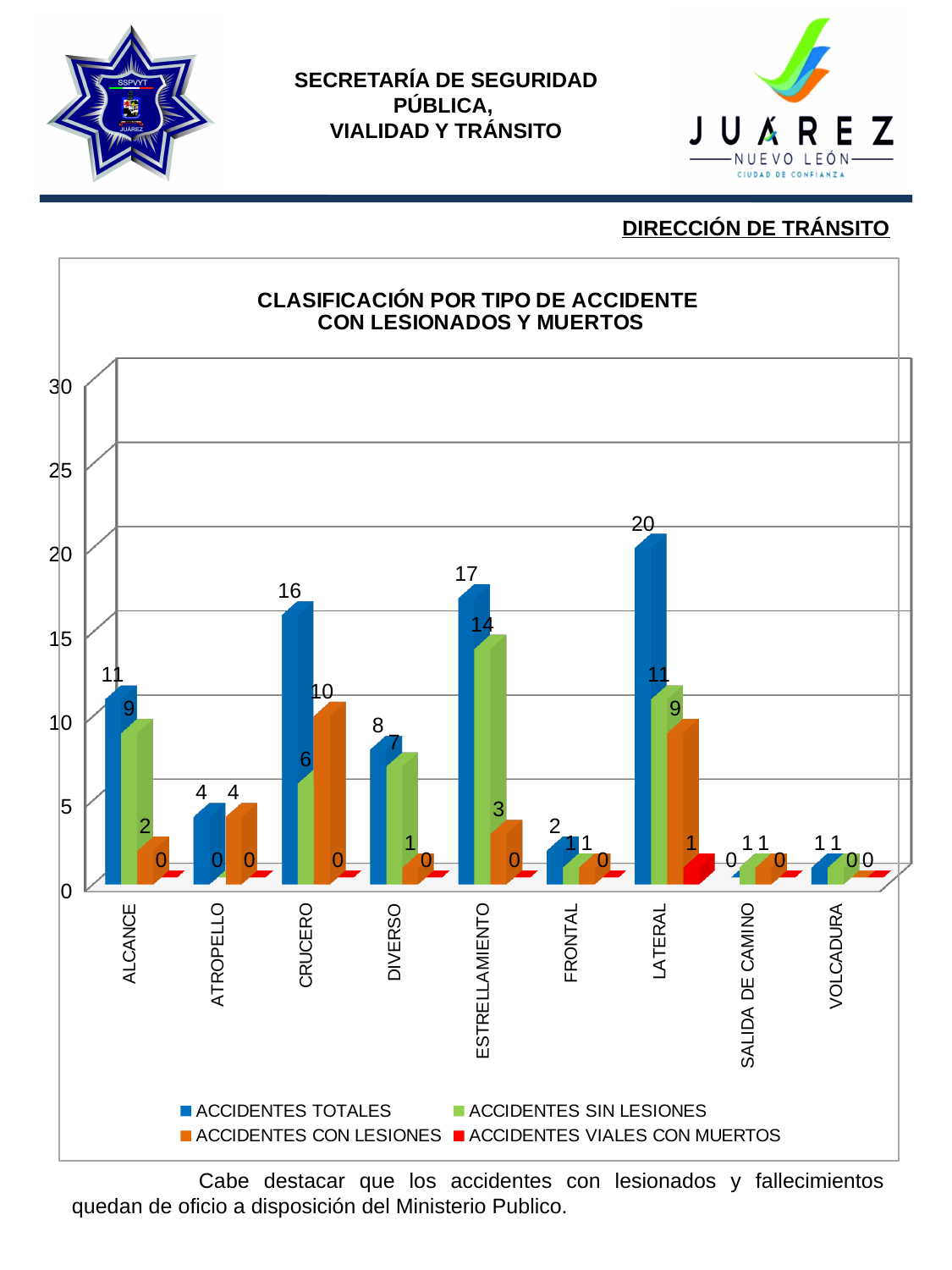
How many series does the legend list? 4 How many accident type categories are shown on the x axis? 9 What kind of chart is shown on the slide? bar chart What is the value of ACCIDENTES VIALES CON MUERTOS for LATERAL? 1 What is the value of ACCIDENTES CON LESIONES for CRUCERO? 10 What is the difference between ACCIDENTES TOTALES for LATERAL and for ESTRELLAMIENTO? 3 What is the value of ACCIDENTES SIN LESIONES for ESTRELLAMIENTO? 14 Which has a larger value for ACCIDENTES TOTALES, CRUCERO or DIVERSO? CRUCERO Which category has the highest value for ACCIDENTES TOTALES? LATERAL What is the value of ACCIDENTES TOTALES for LATERAL? 20 Which category has the highest value for ACCIDENTES CON LESIONES? CRUCERO What is the title of the chart? CLASIFICACIÓN POR TIPO DE ACCIDENTE CON LESIONADOS Y MUERTOS